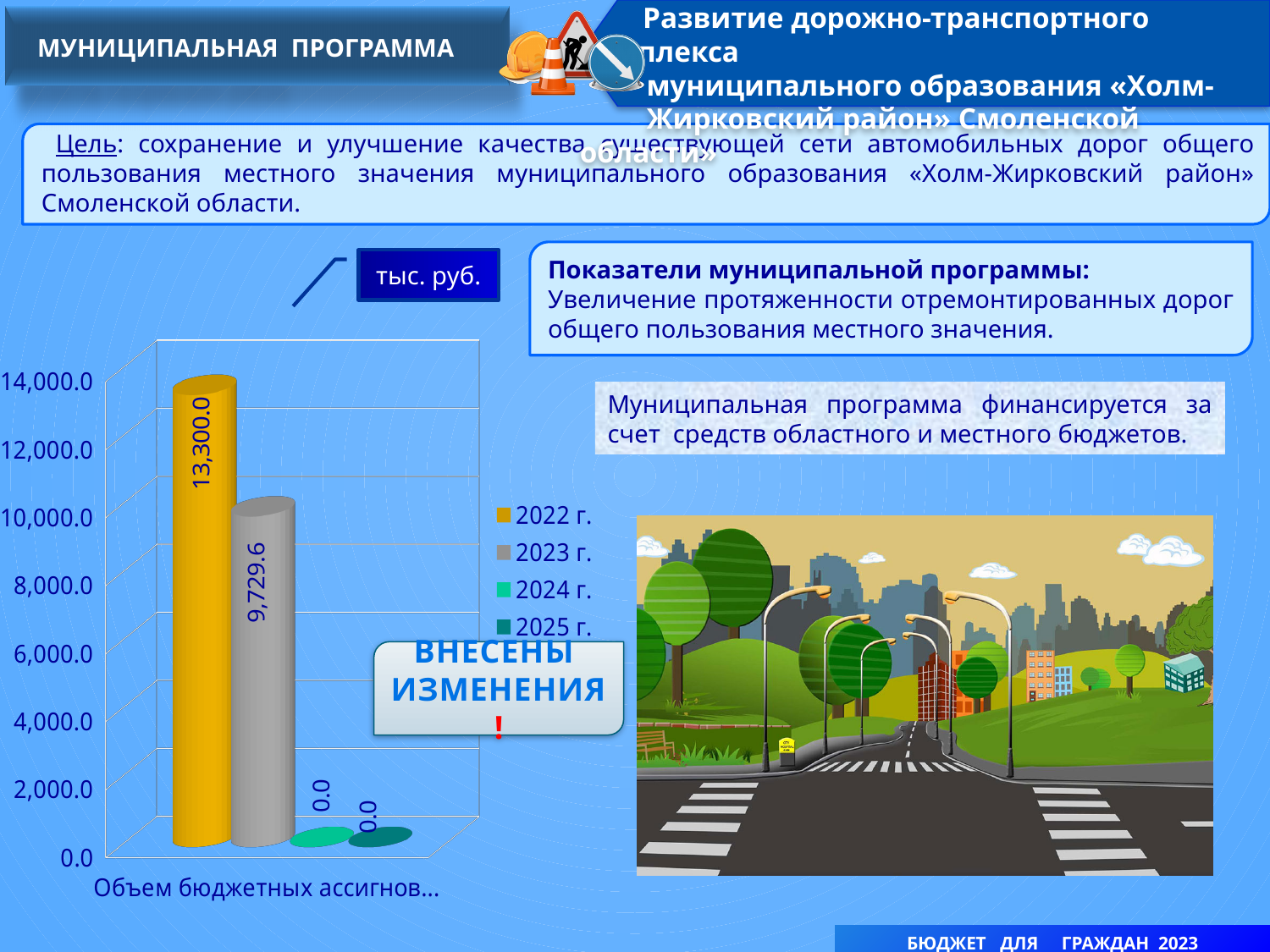
What is the value for 2025 г. in the chart? 0.0 Is the value for 2023 г. greater or less than 10,000.0? less What kind of chart is shown on the slide? bar chart What unit of measurement is indicated for the chart values? тыс. руб. What is the difference between the values for 2022 г. and 2023 г.? 3,570.4 How many series does the chart legend list? 4 Which year has the highest value in the chart? 2022 г. What is the value for 2023 г. in the chart? 9,729.6 What colour is the bar for 2022 г. in the chart? yellow Which is larger, the value for 2022 г. or the value for 2023 г.? 2022 г. What is the value for 2024 г. in the chart? 0.0 What is the value for 2022 г. in the chart? 13,300.0